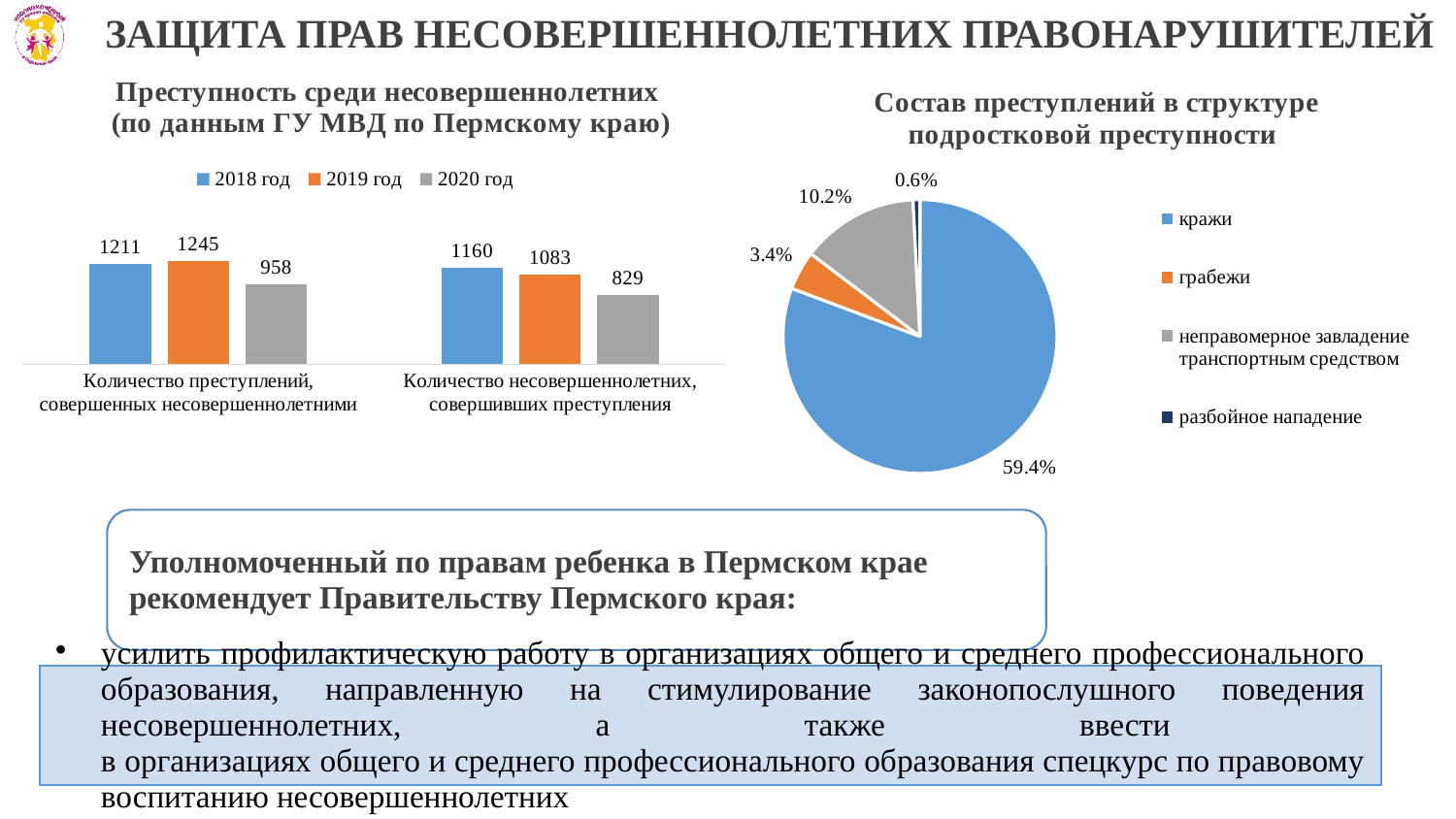
How many categories does the legend of the pie chart "Состав преступлений в структуре подростковой преступности" list? 4 How many series does the legend of the bar chart "Преступность среди несовершеннолетних" list? 3 In the pie chart "Состав преступлений в структуре подростковой преступности", what share is shown for "кражи"? 59.4% In the bar chart "Преступность среди несовершеннолетних", what is the difference between the 2018 год and 2020 год values for "Количество преступлений, совершенных несовершеннолетними"? 253 In the pie chart "Состав преступлений в структуре подростковой преступности", what share is shown for "неправомерное завладение транспортным средством"? 10.2% In the bar chart "Преступность среди несовершеннолетних", what is the value for 2020 год for "Количество несовершеннолетних, совершивших преступления"? 829 In the pie chart "Состав преступлений в структуре подростковой преступности", which category has the smallest slice? разбойное нападение What kind of chart is "Преступность среди несовершеннолетних"? Bar chart In the bar chart "Преступность среди несовершеннолетних", which year has the highest value for "Количество преступлений, совершенных несовершеннолетними"? 2019 год In the bar chart "Преступность среди несовершеннолетних", what is the value for 2019 год for "Количество преступлений, совершенных несовершеннолетними"? 1245 In the bar chart "Преступность среди несовершеннолетних", which is larger for "Количество несовершеннолетних, совершивших преступления": 2018 год or 2019 год? 2018 год In the bar chart "Преступность среди несовершеннолетних", which year has the lowest value for "Количество несовершеннолетних, совершивших преступления"? 2020 год